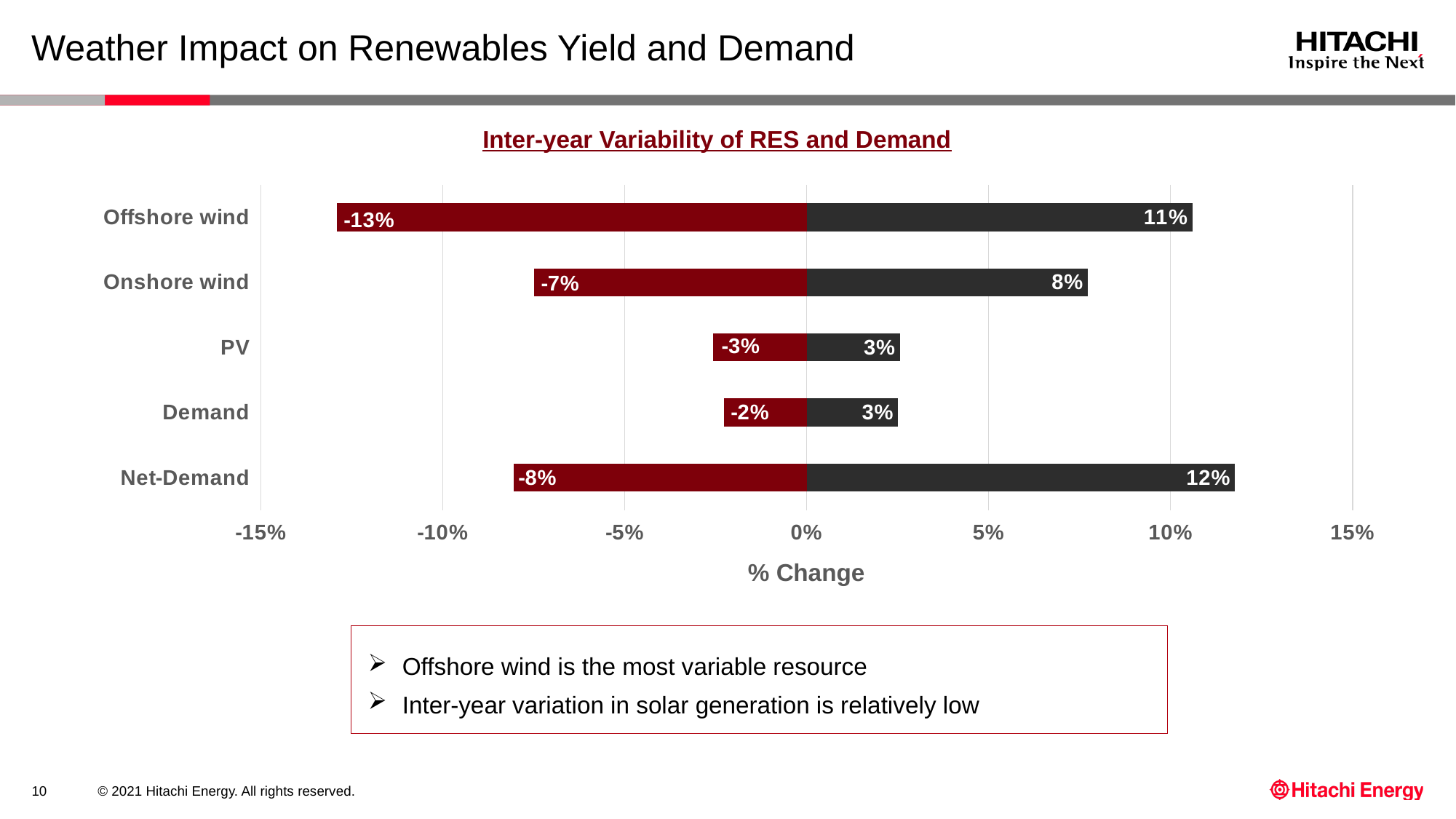
What is the negative value shown for Onshore wind? -7% How many categories are shown on the chart? 5 Which has a larger positive % change, Onshore wind or PV? Onshore wind What is the title of the chart? Inter-year Variability of RES and Demand What is the difference between the positive values for Net-Demand and Offshore wind? 1% What is the positive inter-year variability value shown for Offshore wind? 11% What is the label of the horizontal axis? % Change What is the positive value shown for Demand? 3% What is the negative inter-year variability value shown for Net-Demand? -8% Which category has the largest positive % change? Net-Demand Which category has the most negative % change? Offshore wind What type of chart is shown on the slide? Bar chart